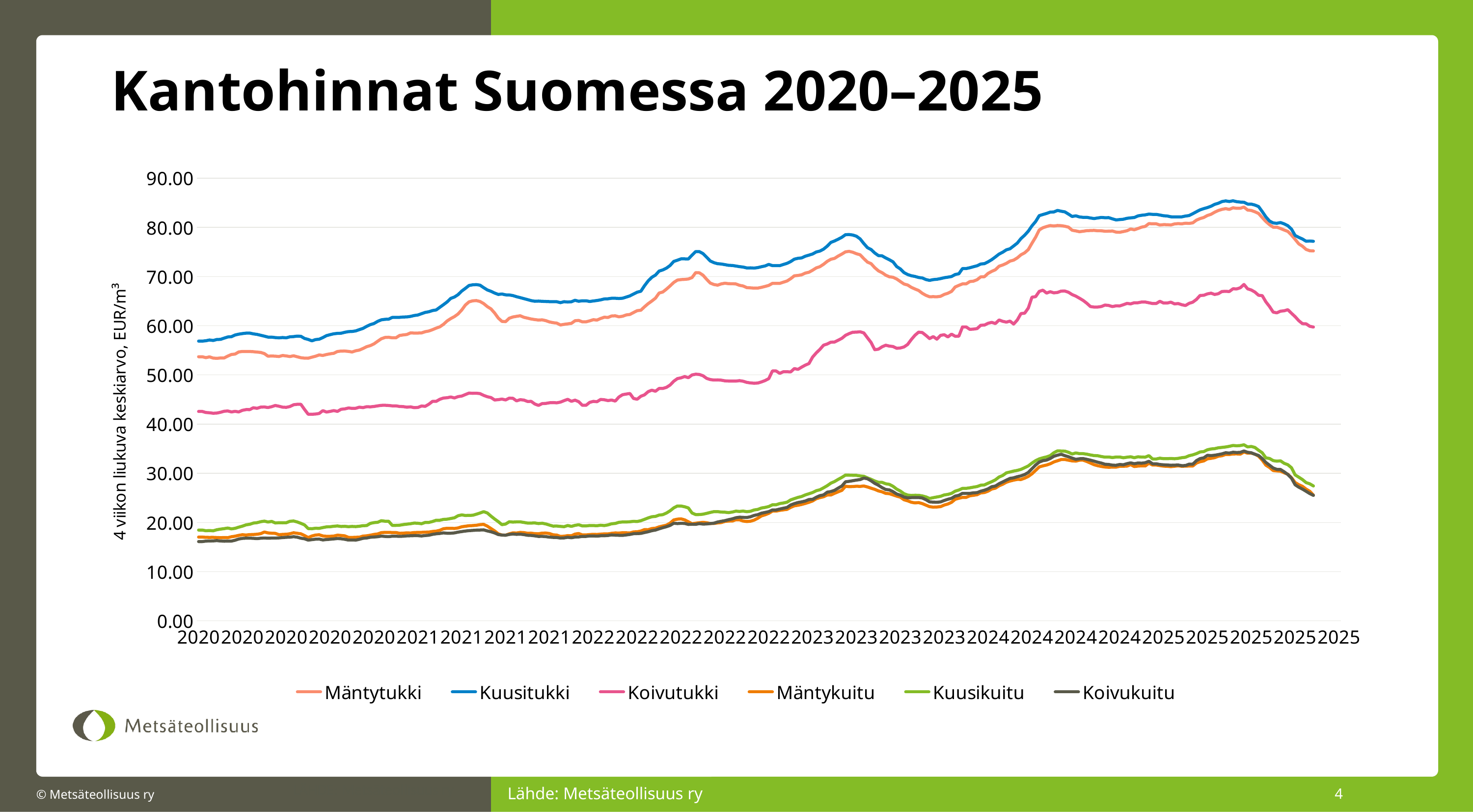
What is the title of the chart? Kantohinnat Suomessa 2020–2025 Which series has the highest values across the whole period? Kuusitukki What kind of chart is shown on the slide? line chart Is the peak value of Kuusitukki in 2025 greater or less than 80? greater Is the value of Mäntytukki at the start of 2020 greater or less than 50? greater Which series is higher throughout the period, Koivutukki or Kuusikuitu? Koivutukki Is the highest value reached by Kuusikuitu greater or less than 30? greater Which series is higher throughout the period, Kuusitukki or Mäntytukki? Kuusitukki Overall, do the Koivutukki values rise or fall from 2020 to 2025? rise What is the label of the vertical axis? 4 viikon liukuva keskiarvo, EUR/m³ How many series does the legend list? 6